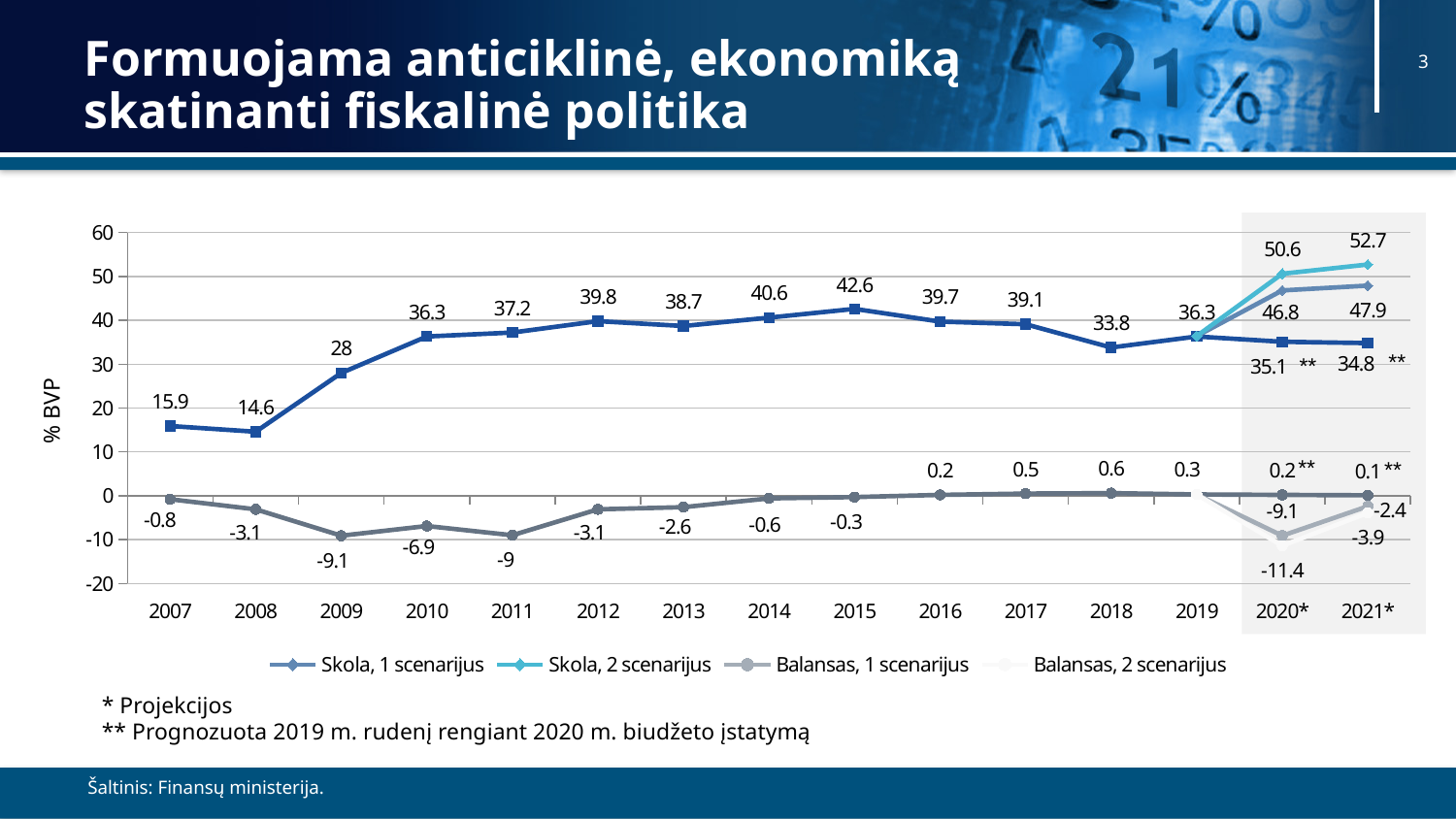
What is the value of Skola, 2 scenarijus for 2021*? 52.7 What is the debt value for 2007? 15.9 How many series does the chart legend list? 4 How many years are shown on the x axis? 15 What is the debt (Skola) value for 2015? 42.6 What is the label of the y axis? % BVP What type of chart is shown on the slide? line chart What is the difference between the debt values for 2010 and 2009? 8.3 In which year between 2007 and 2019 is the debt value lowest? 2008 In which year between 2007 and 2019 is the debt value highest? 2015 Which is larger, the debt value for 2018 or for 2019? 2019 What is the balance (Balansas) value for 2009? -9.1